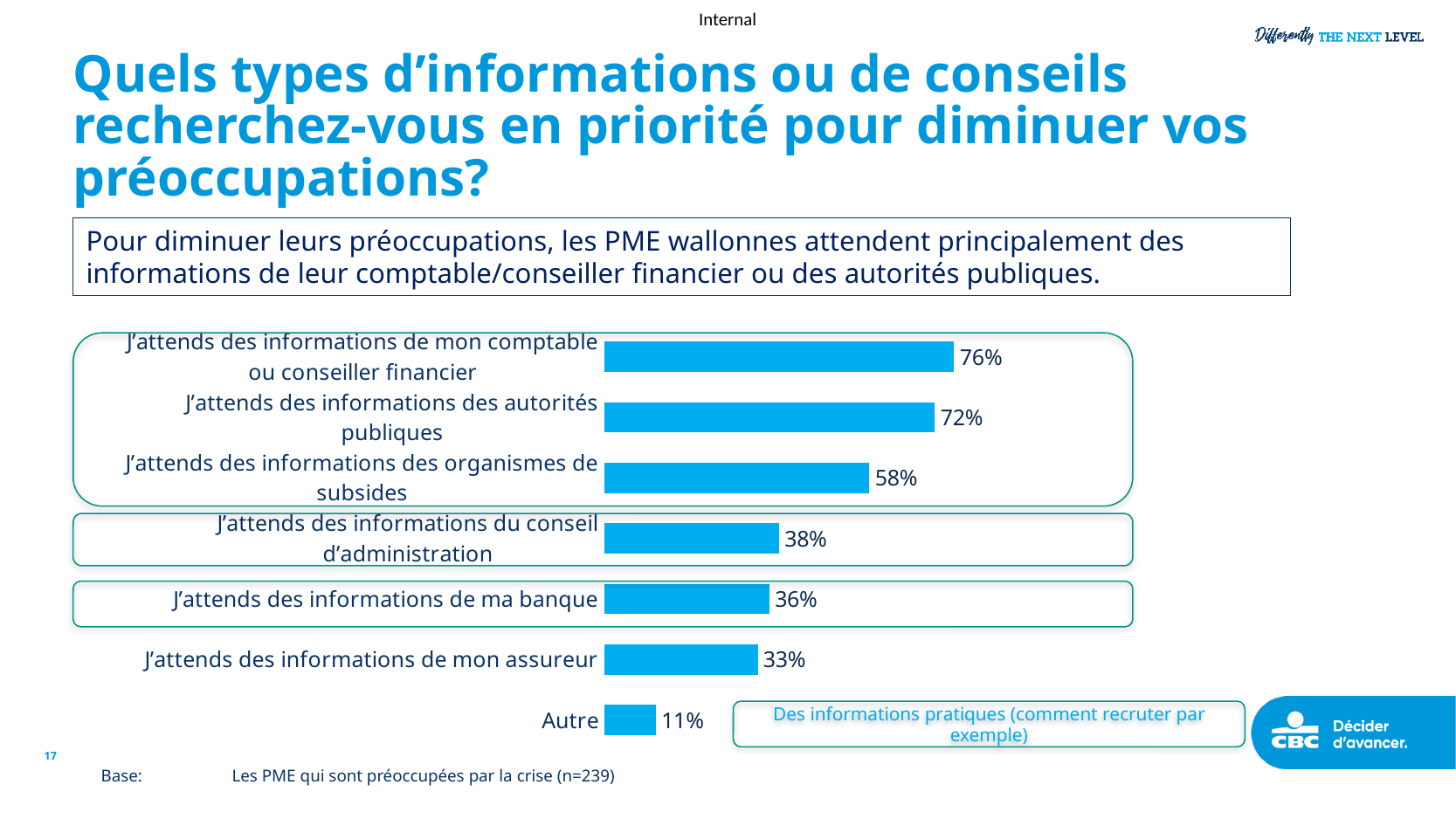
What is the difference between the values for "J'attends des informations des organismes de subsides" and "J'attends des informations du conseil d'administration"? 20% Which category has the highest value? J'attends des informations de mon comptable ou conseiller financier What kind of chart is shown on the slide? Bar chart Which is larger: the value for "J'attends des informations de ma banque" or for "J'attends des informations de mon assureur"? J'attends des informations de ma banque What is the base (n) stated for the chart? n=239 What is the value for "J'attends des informations de mon comptable ou conseiller financier"? 76% What is the value for "J'attends des informations des autorités publiques"? 72% What is the difference between the values for "J'attends des informations de mon comptable ou conseiller financier" and "J'attends des informations des autorités publiques"? 4% What is the value for "J'attends des informations de ma banque"? 36% Which category has the lowest value? Autre How many categories are shown in the chart? 7 What is the value for "Autre"? 11%